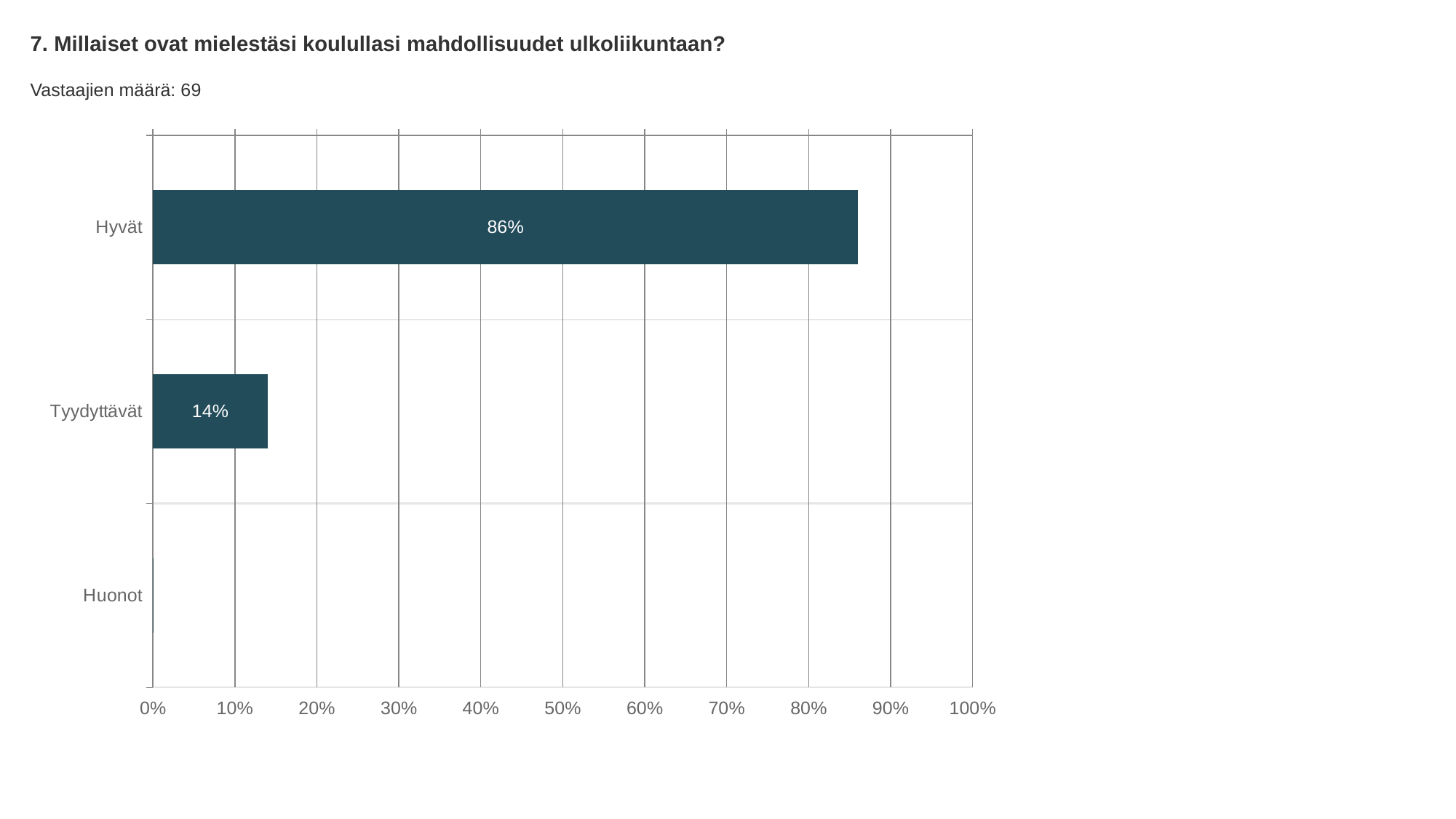
What kind of chart is shown on the slide? bar chart Is the value for Tyydyttävät greater or less than 20%? less How many categories are shown in the chart? 3 Is the value for Hyvät greater or less than 80%? greater Which is larger, the value for Hyvät or the value for Tyydyttävät? Hyvät What is the value for Tyydyttävät? 14% Which category has the lowest value? Huonot Which category has the highest value? Hyvät What is the difference between the values for Hyvät and Tyydyttävät? 72% What is the maximum value shown on the horizontal axis? 100% How many respondents (Vastaajien määrä) are reported on the slide? 69 What is the value for Hyvät? 86%